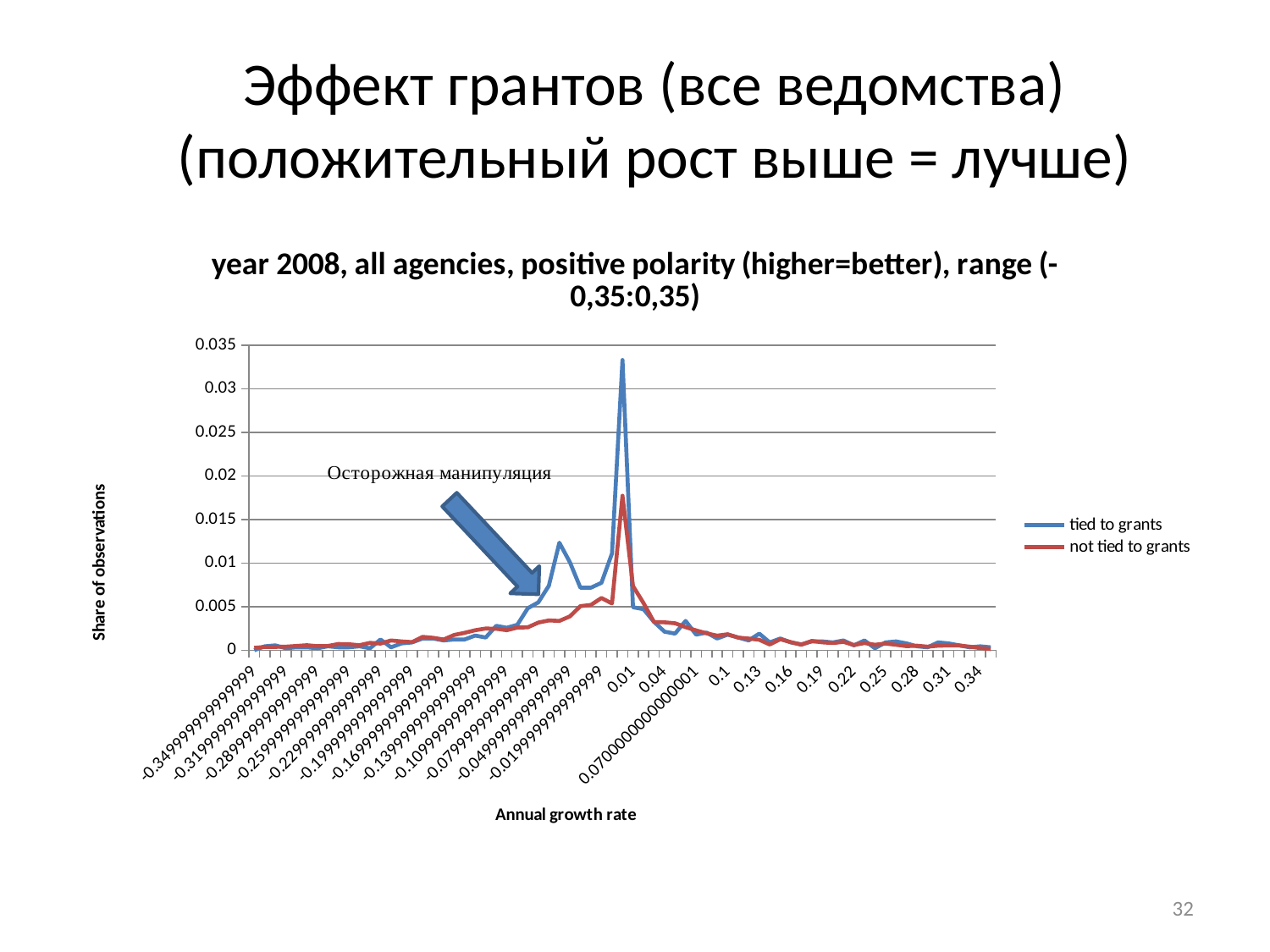
What kind of chart is shown on the slide? line chart After the peak near 0.01, does the 'not tied to grants' series rise or fall toward the right end of the axis? fall What are the two series named in the legend? tied to grants; not tied to grants Is the value of the 'not tied to grants' series at the leftmost point of the axis greater or less than 0.005? less Between the left end of the x axis and the peak near 0.01, does the 'tied to grants' series generally rise or fall? rise Which series reaches the higher peak, 'tied to grants' or 'not tied to grants'? tied to grants How many series does the legend list? 2 Is the peak value of the 'not tied to grants' series greater or less than 0.015? greater Is the peak value of the 'tied to grants' series greater or less than 0.03? greater What is the title of the vertical axis? Share of observations